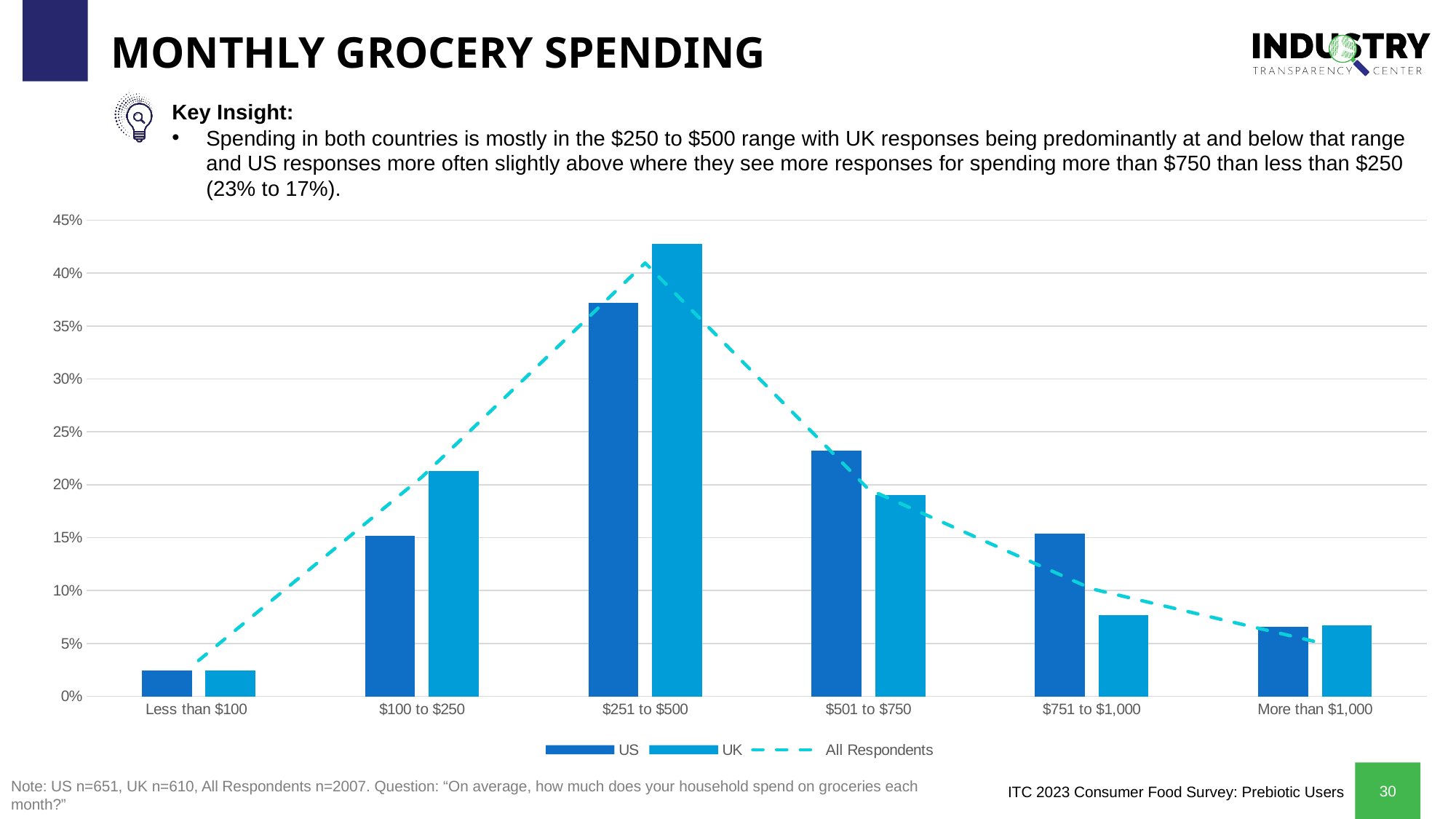
How many series does the legend list? 3 For the $100 to $250 category, which is larger, the US or the UK value? UK Is the US value for $251 to $500 greater or less than 35%? greater Which spending category has the lowest US value? Less than $100 For the $501 to $750 category, which is larger, the US or the UK value? US Is the UK value for $751 to $1,000 greater or less than 10%? less What kind of chart is shown on the slide? Bar chart with a dashed line Which series is drawn as a dashed line? All Respondents Is the UK value for $251 to $500 greater or less than 40%? greater Which spending category has the highest UK value? $251 to $500 Do the US values rise or fall from $251 to $500 through More than $1,000? fall How many spending categories are shown on the x axis? 6